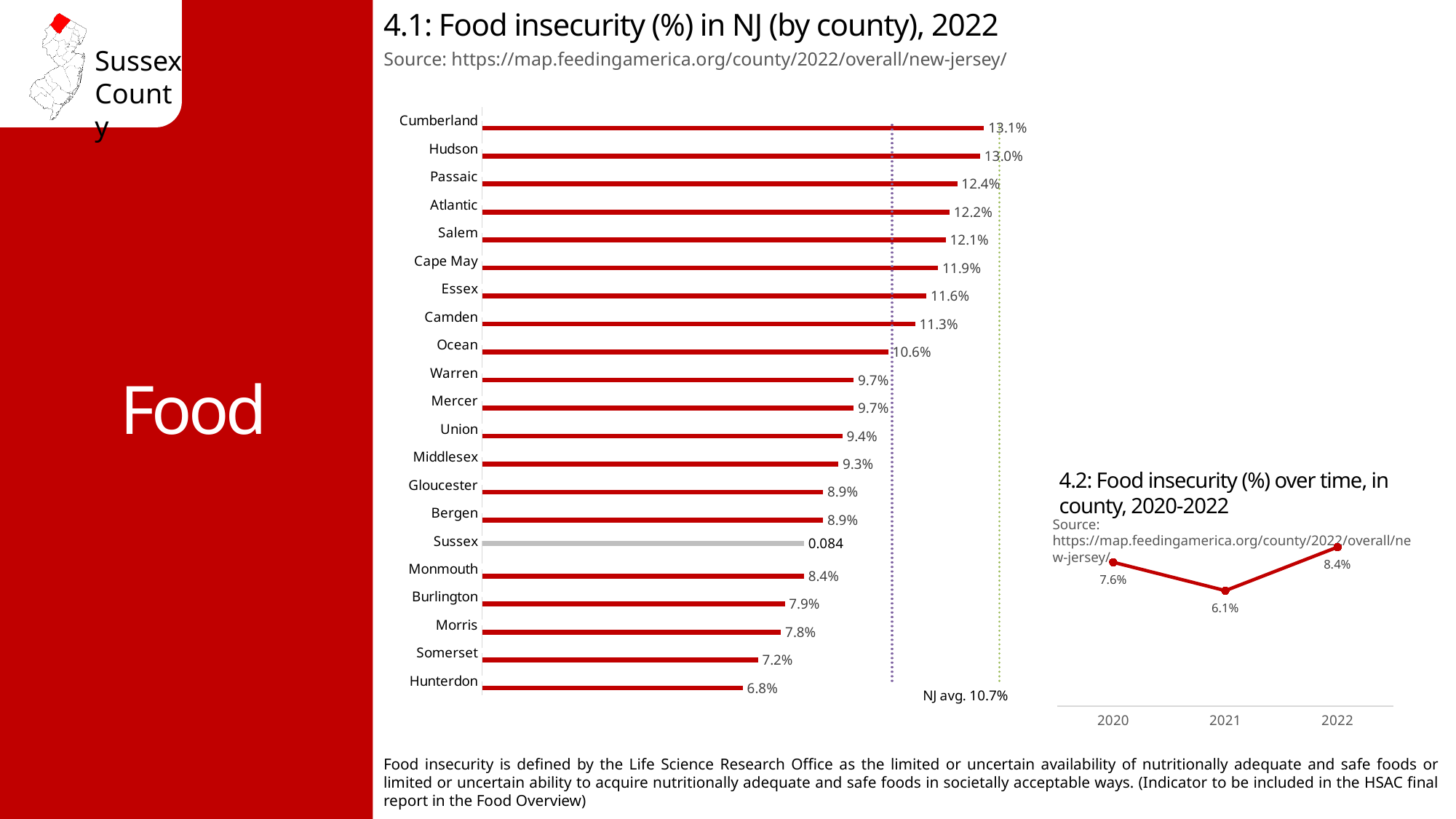
In chart 4.1 (Food insecurity in NJ by county, 2022), which county has the lowest value? Hunterdon In chart 4.2 (Food insecurity over time in county, 2020-2022), what is the difference between the 2022 and 2021 values? 2.3 percentage points In chart 4.2 (Food insecurity over time in county, 2020-2022), what is the value for 2021? 6.1% In chart 4.1 (Food insecurity in NJ by county, 2022), what NJ average value is marked by the dotted line? 10.7% What kind of chart is chart 4.1 (Food insecurity in NJ by county, 2022)? Bar chart In chart 4.1 (Food insecurity in NJ by county, 2022), what is the difference between Cumberland and Hunterdon? 6.3 percentage points In chart 4.1 (Food insecurity in NJ by county, 2022), which is larger, the value for Passaic or the value for Atlantic? Passaic In chart 4.1 (Food insecurity in NJ by county, 2022), which county has the highest value? Cumberland In chart 4.1 (Food insecurity in NJ by county, 2022), what data label is shown for Sussex? 0.084 In chart 4.1 (Food insecurity in NJ by county, 2022), how many counties are plotted? 21 What kind of chart is chart 4.2 (Food insecurity over time in county, 2020-2022)? Line chart In chart 4.1 (Food insecurity in NJ by county, 2022), what is the value for Cumberland? 13.1%